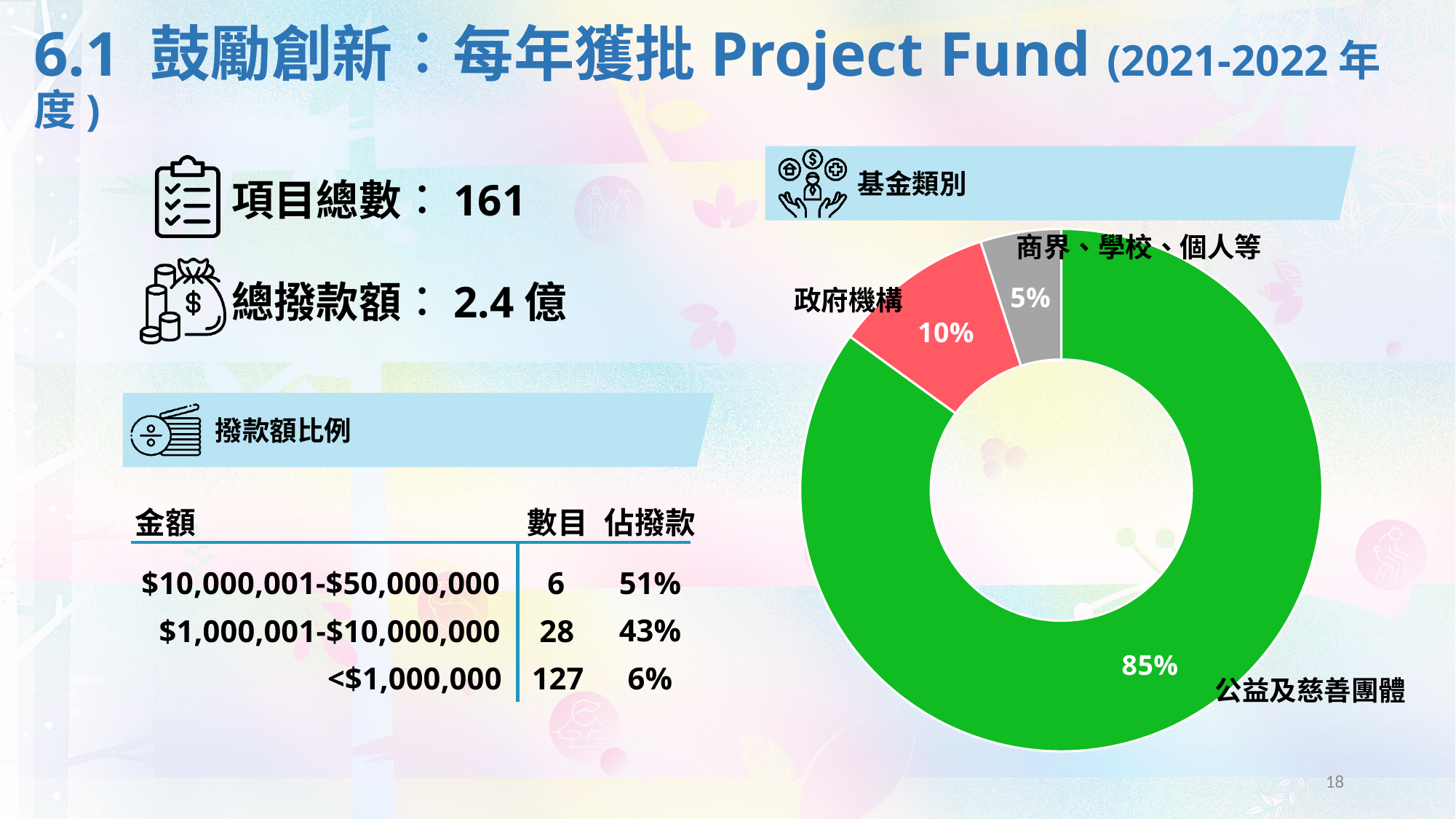
What kind of chart is used for 基金類別? Donut (pie) chart Which category has the smallest slice in the 基金類別 chart? 商界、學校、個人等 Which category has the largest slice in the 基金類別 chart? 公益及慈善團體 What percentage does the 基金類別 chart show for 政府機構? 10% What share of the 基金類別 donut chart is 公益及慈善團體? 85% In the 基金類別 chart, which is larger: 政府機構 or 商界、學校、個人等? 政府機構 How many categories are shown in the 基金類別 chart? 3 What colour is the 政府機構 slice in the 基金類別 chart? Red In the 基金類別 chart, what is the difference in percentage points between 公益及慈善團體 and 政府機構? 75 What percentage does the 基金類別 chart show for 商界、學校、個人等? 5% What is the title of the donut chart on the slide? 基金類別 In the 基金類別 chart, what is the difference in percentage points between 政府機構 and 商界、學校、個人等? 5